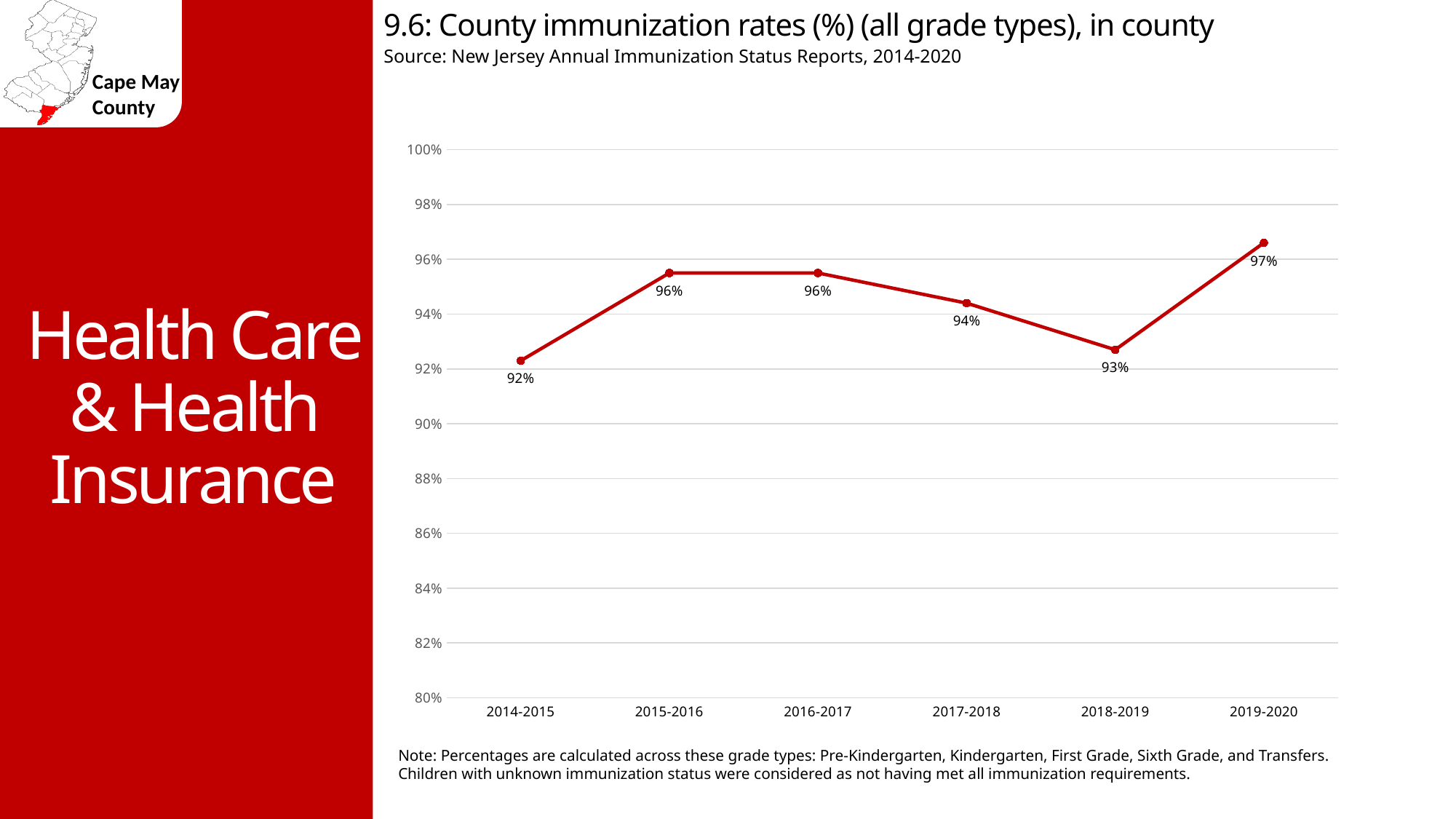
Is the immunization rate for 2018-2019 greater or less than 94%? less Which school year has the lowest immunization rate? 2014-2015 What is the county immunization rate for 2014-2015? 92% Which year has a higher immunization rate, 2017-2018 or 2018-2019? 2017-2018 What is the county immunization rate for 2017-2018? 94% What kind of chart is shown on the slide? line chart What is the difference in immunization rate between 2019-2020 and 2014-2015? 5% What is the county immunization rate for 2019-2020? 97% Which school year has the highest immunization rate? 2019-2020 How many school years are plotted on the chart? 6 Did the immunization rate rise or fall from 2018-2019 to 2019-2020? rise What is the county immunization rate for 2018-2019? 93%